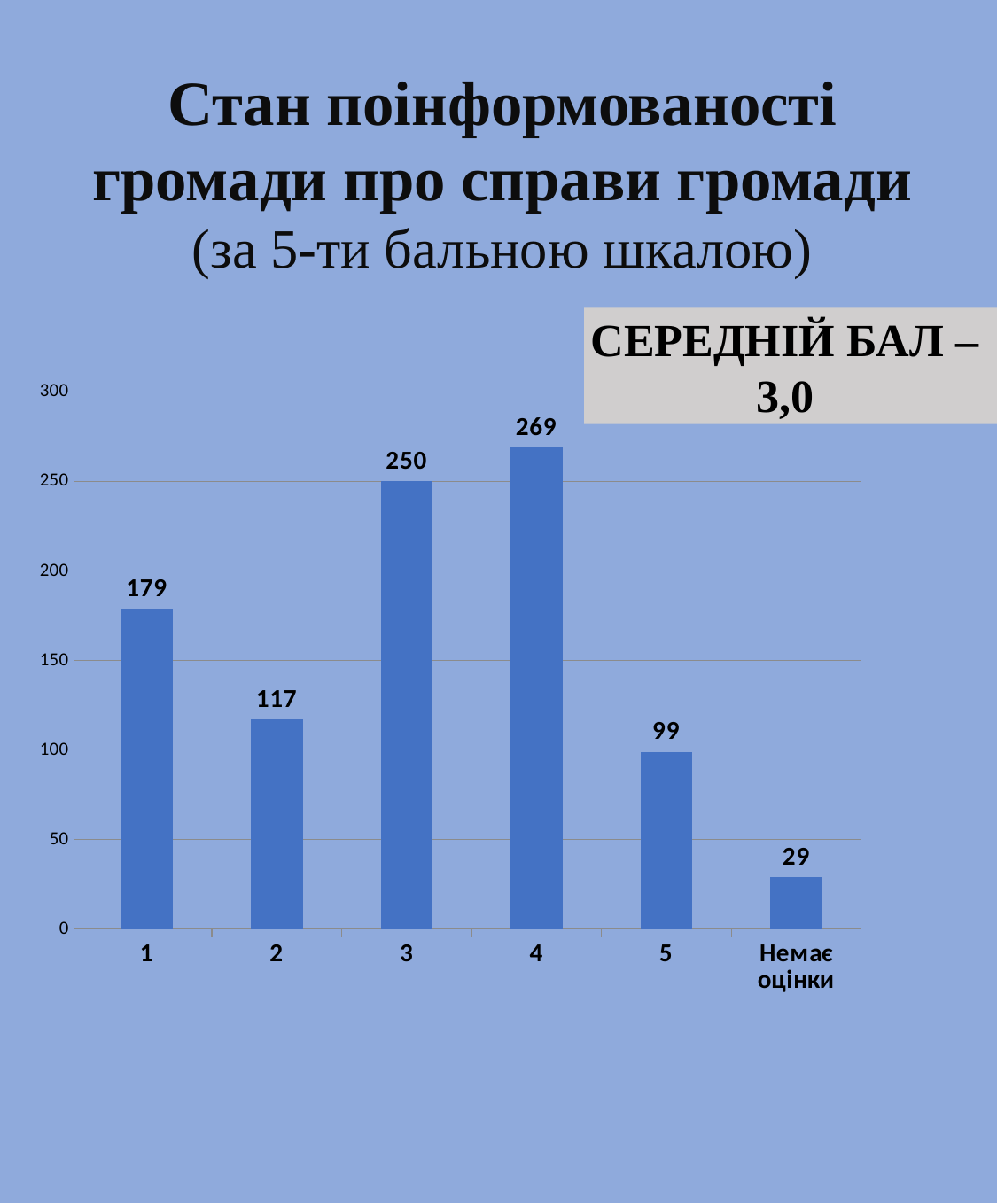
What is the value for the category "Немає оцінки"? 29 What is the difference between the values for category 1 and category 2? 62 What is the difference between the values for category 4 and category 3? 19 What average score (СЕРЕДНІЙ БАЛ) is stated on the slide? 3,0 What kind of chart is shown on the slide? bar chart Which category has the lowest value? Немає оцінки What is the value for category 3? 250 What is the value for category 1? 179 Is the value for category 5 greater or less than 100? less How many categories are shown on the x axis? 6 Which is larger, the value for category 2 or the value for category 5? 2 Which category has the highest value? 4